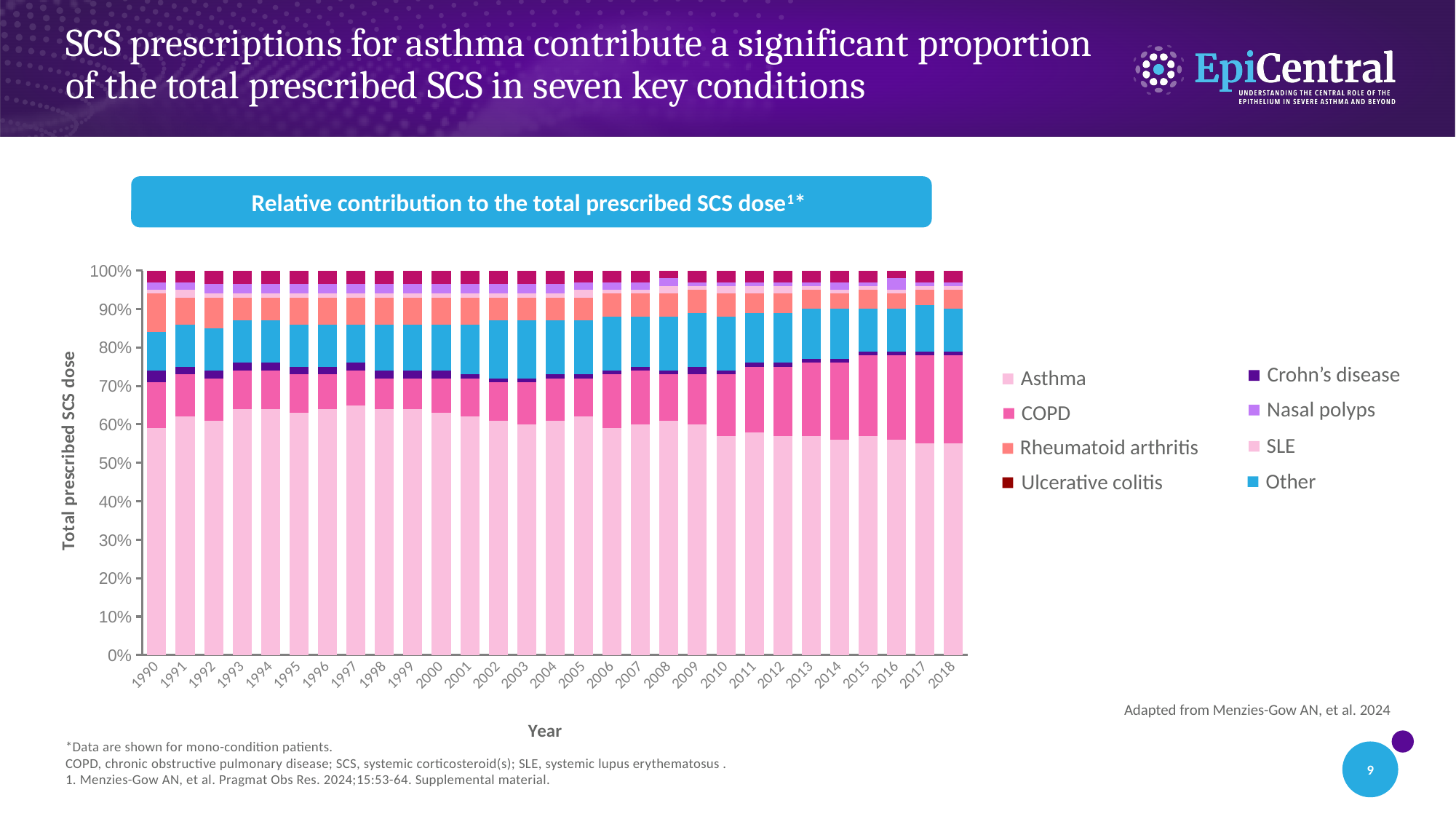
Is the Asthma share of the total prescribed SCS dose in 2018 greater or less than 60%? less How many years are plotted along the x axis of the chart? 29 Is the Asthma share of the total prescribed SCS dose in 1990 greater or less than 50%? greater How many series does the chart's legend list? 8 Which is larger in 2018, the Asthma share or the COPD share of the total prescribed SCS dose? Asthma Which series contributes the largest share of the total prescribed SCS dose in every year shown? Asthma Is the Asthma share of the total prescribed SCS dose in 1997 greater or less than 60%? greater What is the title of the chart? Relative contribution to the total prescribed SCS dose What kind of chart is shown on the slide? Stacked bar chart What is the label of the y axis? Total prescribed SCS dose What is the first year and the last year shown on the x axis? 1990 and 2018